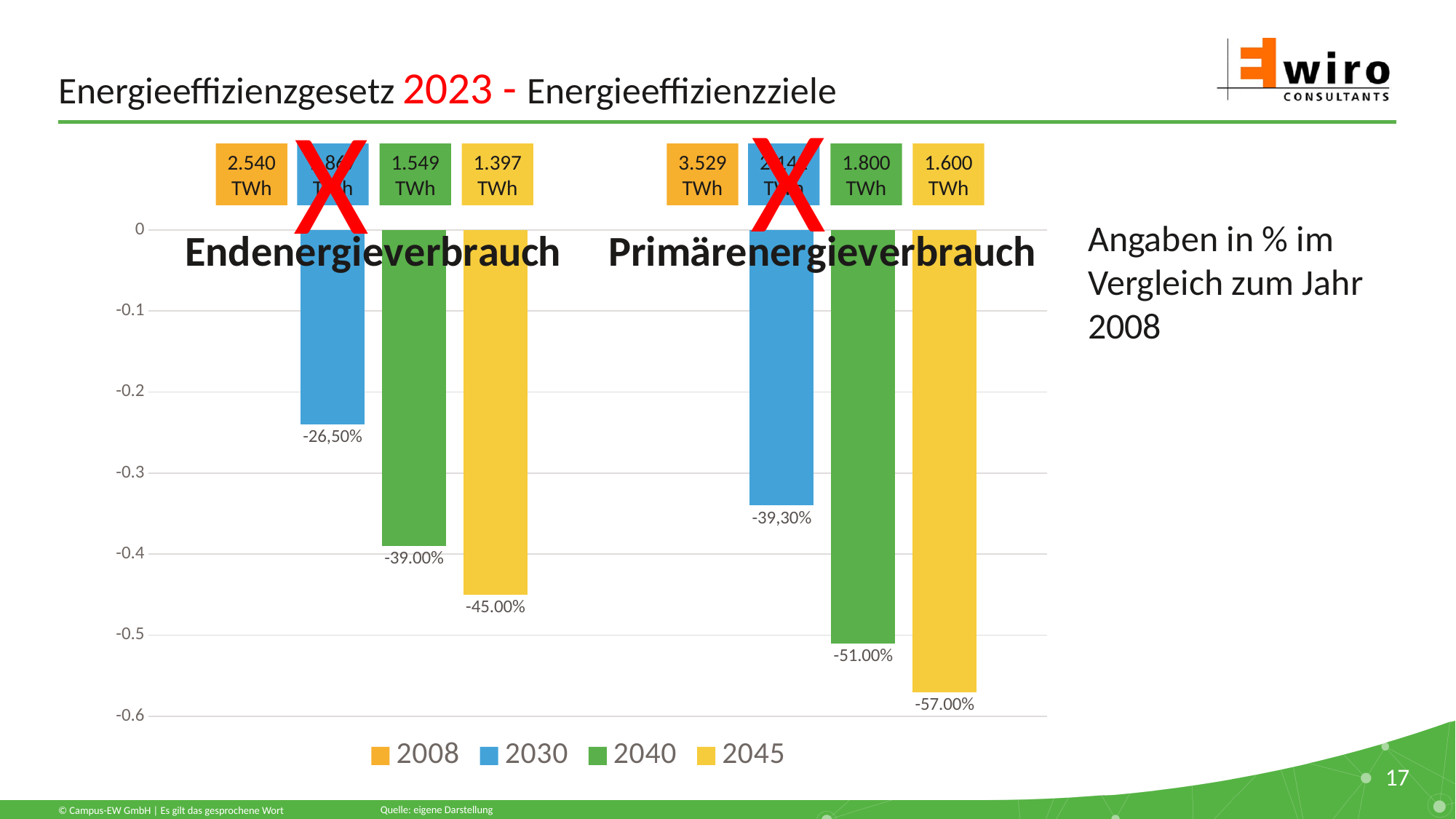
What is the value for 2045 in the Primärenergieverbrauch category? -57.00% What is the value for 2030 in the Primärenergieverbrauch category? -39,30% What is the value for 2030 in the Endenergieverbrauch category? -26,50% Which is more negative: the 2040 value for Endenergieverbrauch or the 2040 value for Primärenergieverbrauch? Primärenergieverbrauch What kind of chart is shown on the slide? bar chart What is the value for 2040 in the Endenergieverbrauch category? -39.00% How many series does the legend list? 4 What is the difference between the 2045 and 2040 values in the Endenergieverbrauch category? 6.00% What TWh value is shown in the box above the 2008 bar for Primärenergieverbrauch? 3.529 TWh Is the 2045 value for Primärenergieverbrauch above or below -0.5 on the axis? below Which series has the lowest (most negative) value in the Primärenergieverbrauch category? 2045 Do the values for Endenergieverbrauch rise or fall from 2030 to 2045? fall